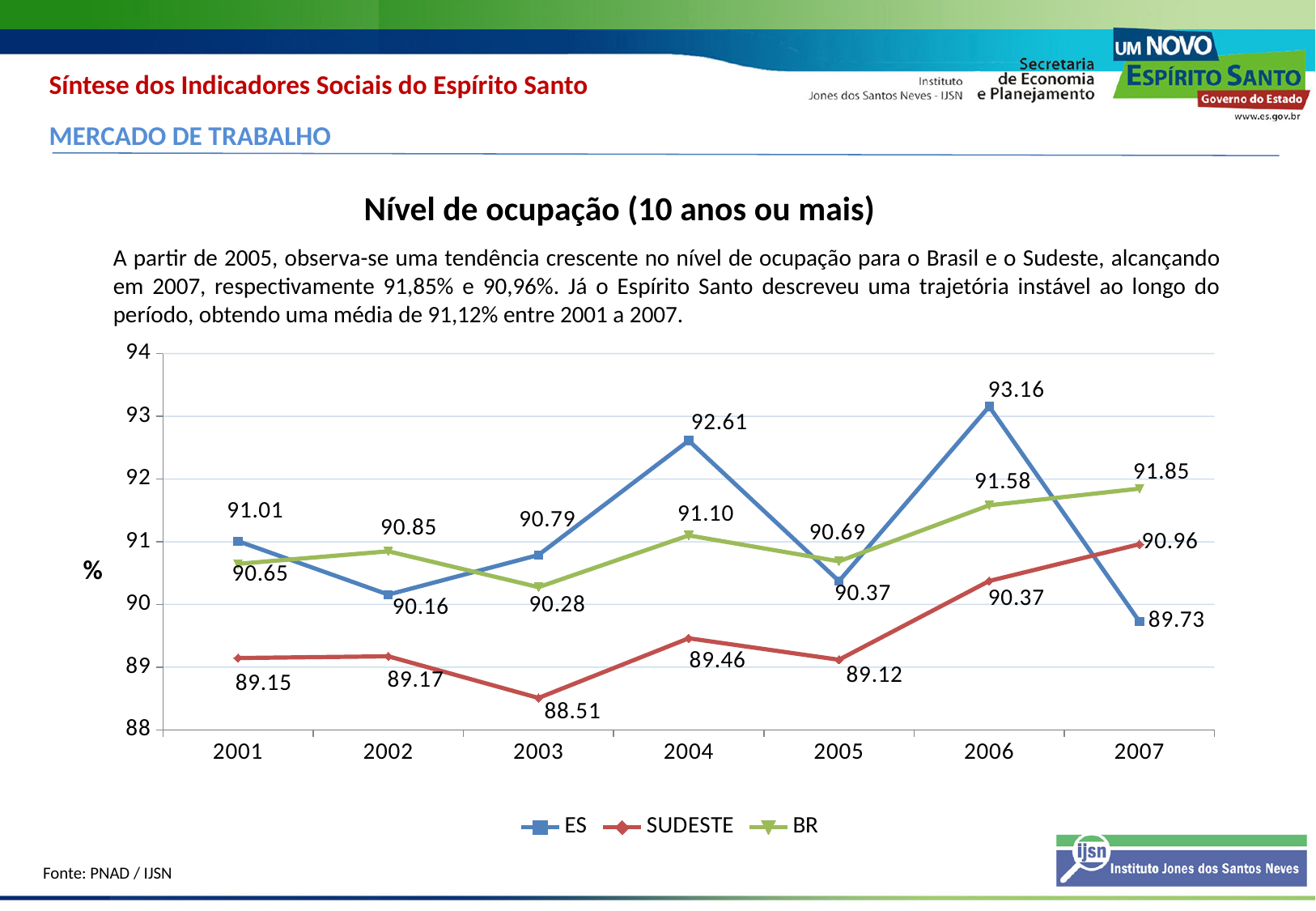
In which year does the ES series reach its highest value? 2006 How many series does the legend list? 3 How many years are plotted on the x axis? 7 What is the difference between the ES values for 2006 and 2007? 3.43 What kind of chart is shown on the slide? Line chart In which year does the SUDESTE series reach its lowest value? 2003 Which series has the larger value in 2007, ES or BR? BR What is the value for BR in 2007? 91.85 What is the value for ES in 2006? 93.16 What label is shown on the y axis of the chart? % What is the value for SUDESTE in 2003? 88.51 Does the SUDESTE series rise or fall from 2005 to 2007? Rise